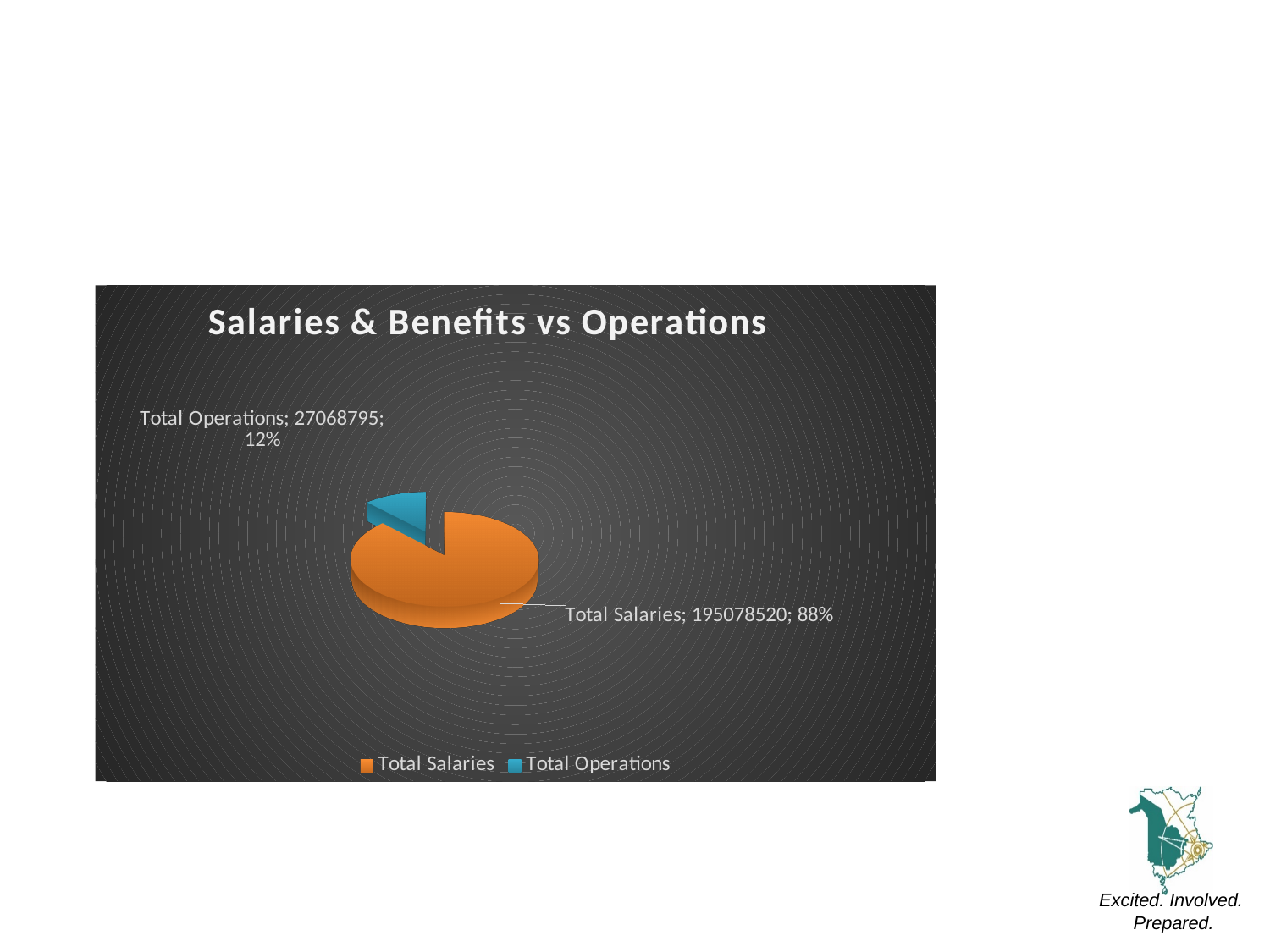
What is the total of Total Salaries and Total Operations? 222147315 Which is larger, Total Salaries or Total Operations? Total Salaries What kind of chart is shown? Pie chart What is the value for Total Operations? 27068795 What is the difference between Total Salaries and Total Operations? 168009725 What is the value for Total Salaries? 195078520 What share of the pie does Total Operations represent? 12% Which slice is the largest? Total Salaries What is the title of the chart? Salaries & Benefits vs Operations What share of the pie does Total Salaries represent? 88% Which slice is the smallest? Total Operations How many slices does the pie chart have? 2